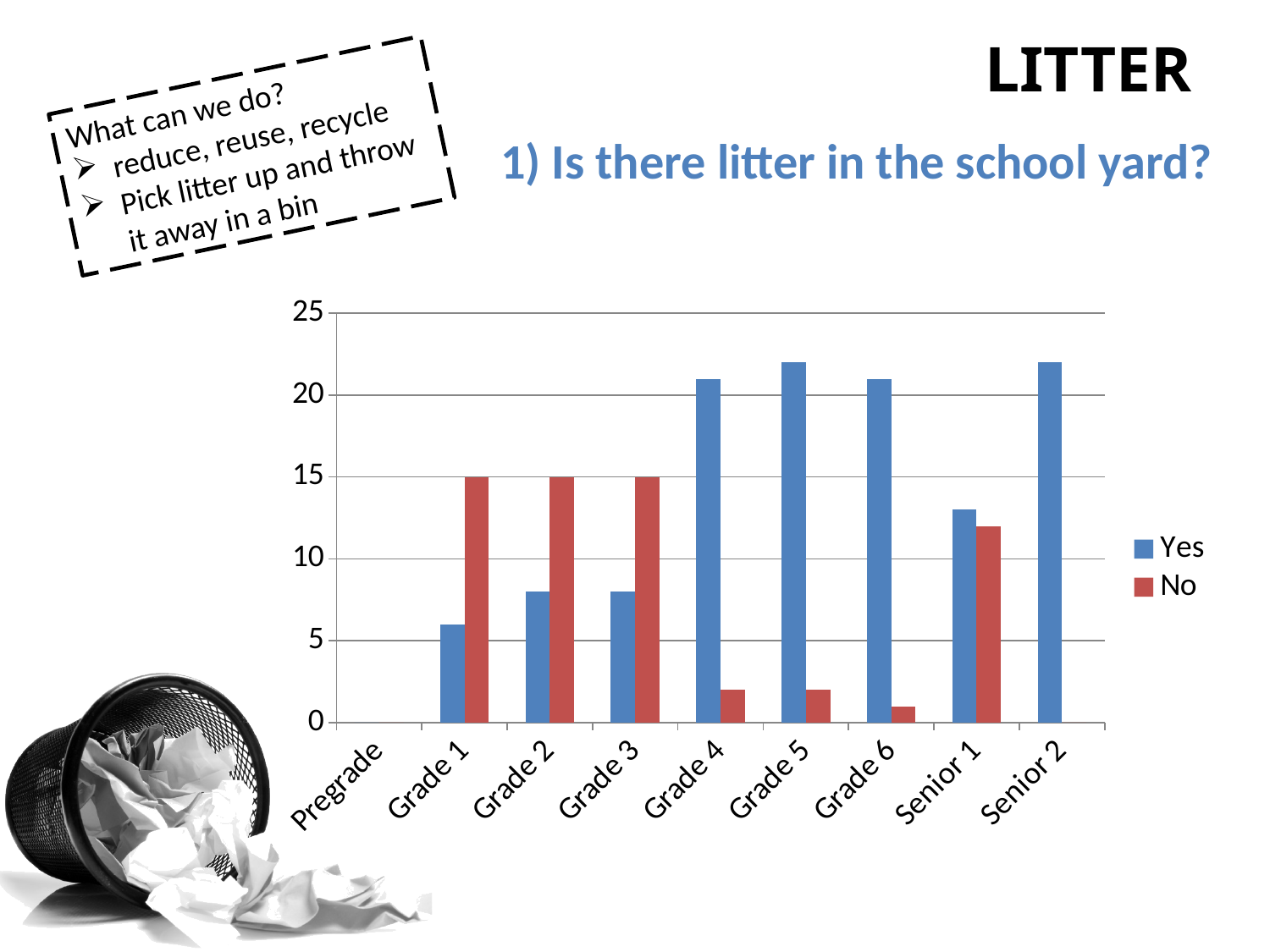
For Grade 1, which is larger, the 'Yes' value or the 'No' value? No What kind of chart is shown on the slide? bar chart How many series does the chart legend list? 2 Is the 'No' value for Grade 6 greater or less than 5? less What are the two series named in the chart legend? Yes and No Is the 'Yes' value for Grade 4 greater or less than 20? greater Is the 'Yes' value for Grade 2 greater or less than 10? less Among the grades with a visible 'Yes' bar, which has the lowest 'Yes' value? Grade 1 Which colour represents the 'No' series in the chart? red For Grade 4, which is larger, the 'Yes' value or the 'No' value? Yes How many categories are shown on the x axis of the chart? 9